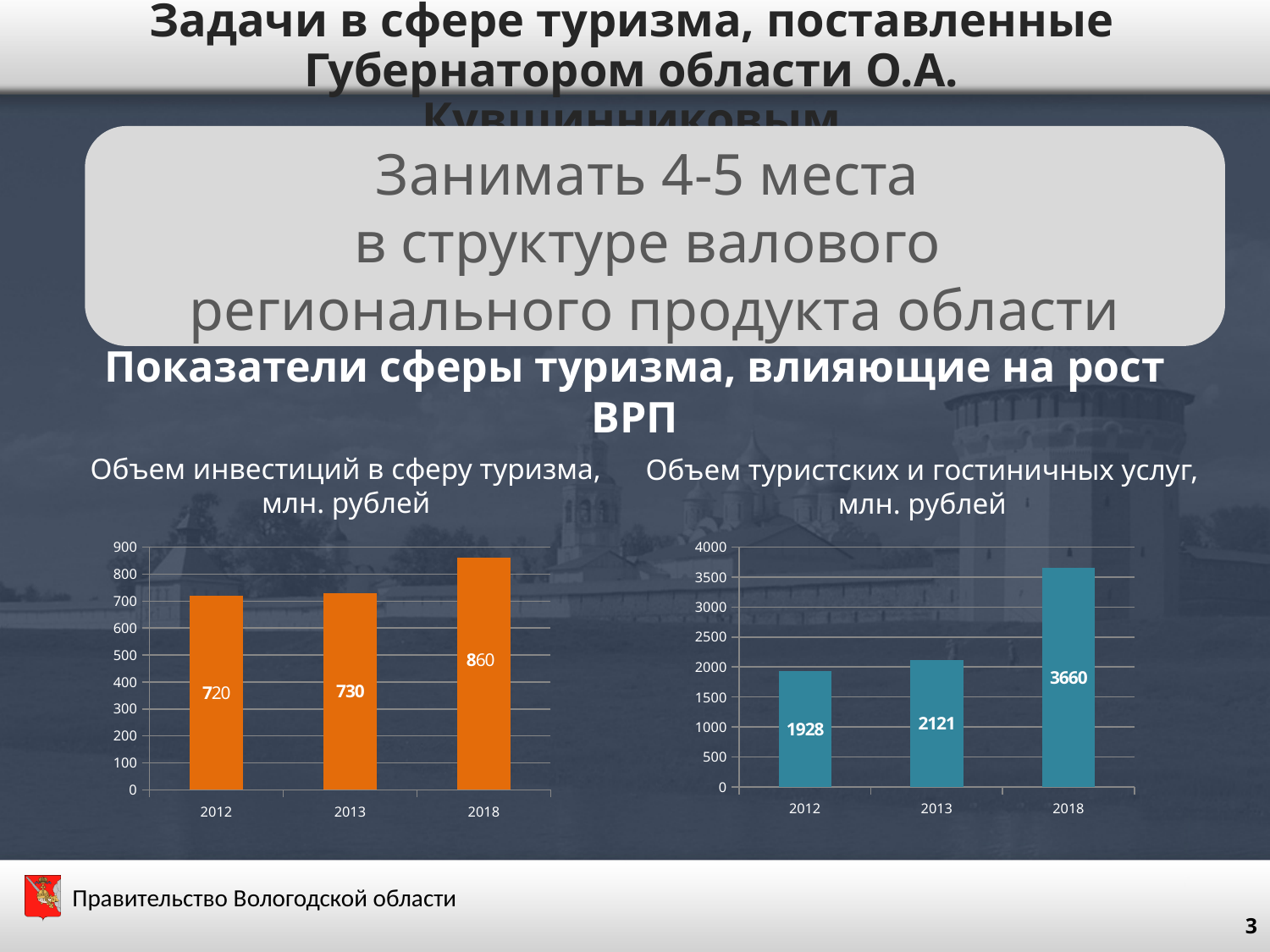
In the chart 'Объем туристских и гостиничных услуг, млн. рублей', which is larger: the value for 2013 or the value for 2018? 2018 In the chart 'Объем инвестиций в сферу туризма, млн. рублей', what is the difference between the 2018 and 2012 values? 140 What kind of chart is 'Объем туристских и гостиничных услуг, млн. рублей'? Bar chart In the chart 'Объем туристских и гостиничных услуг, млн. рублей', which year has the lowest value? 2012 How many years are shown on the x axis of the chart 'Объем инвестиций в сферу туризма, млн. рублей'? 3 In the chart 'Объем инвестиций в сферу туризма, млн. рублей', what is the value for 2018? 860 In the chart 'Объем туристских и гостиничных услуг, млн. рублей', what is the value for 2012? 1928 In the chart 'Объем туристских и гостиничных услуг, млн. рублей', what is the difference between the 2013 and 2012 values? 193 In the chart 'Объем туристских и гостиничных услуг, млн. рублей', what is the value for 2018? 3660 In the chart 'Объем туристских и гостиничных услуг, млн. рублей', do the values rise or fall from 2012 to 2018? Rise In the chart 'Объем инвестиций в сферу туризма, млн. рублей', which year has the highest value? 2018 In the chart 'Объем инвестиций в сферу туризма, млн. рублей', what is the value for 2013? 730